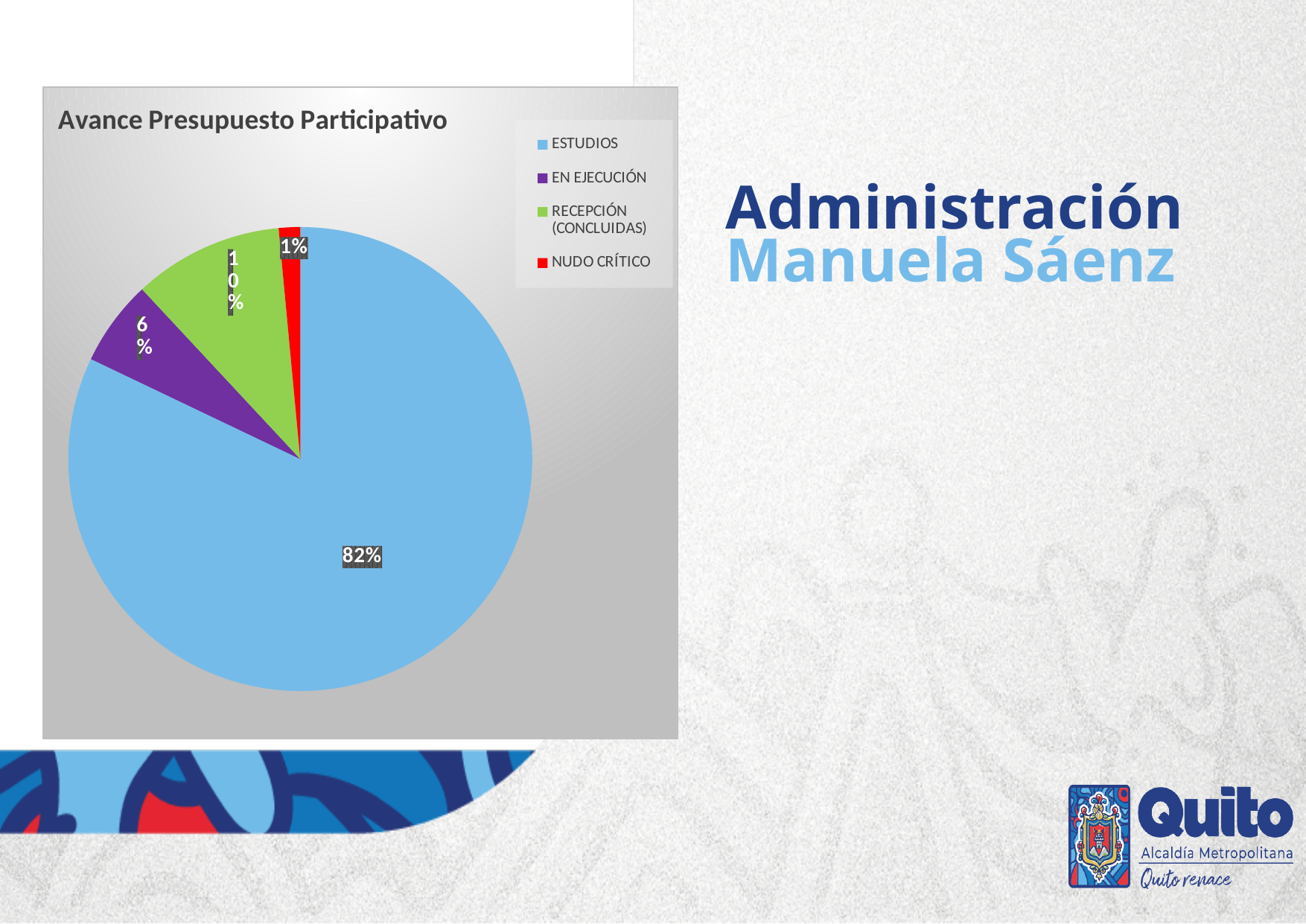
What share of the pie does NUDO CRÍTICO represent? 1% How many categories does the legend list? 4 What is the difference in percentage points between ESTUDIOS and RECEPCIÓN (CONCLUIDAS)? 72 What share of the pie does EN EJECUCIÓN represent? 6% What colour is the slice for NUDO CRÍTICO? Red What share of the pie does RECEPCIÓN (CONCLUIDAS) represent? 10% Which category has the smallest slice of the pie? NUDO CRÍTICO Which is larger, the share for EN EJECUCIÓN or the share for RECEPCIÓN (CONCLUIDAS)? RECEPCIÓN (CONCLUIDAS) Which category has the largest slice of the pie? ESTUDIOS What is the title of the chart? Avance Presupuesto Participativo What kind of chart is shown on the slide? Pie chart